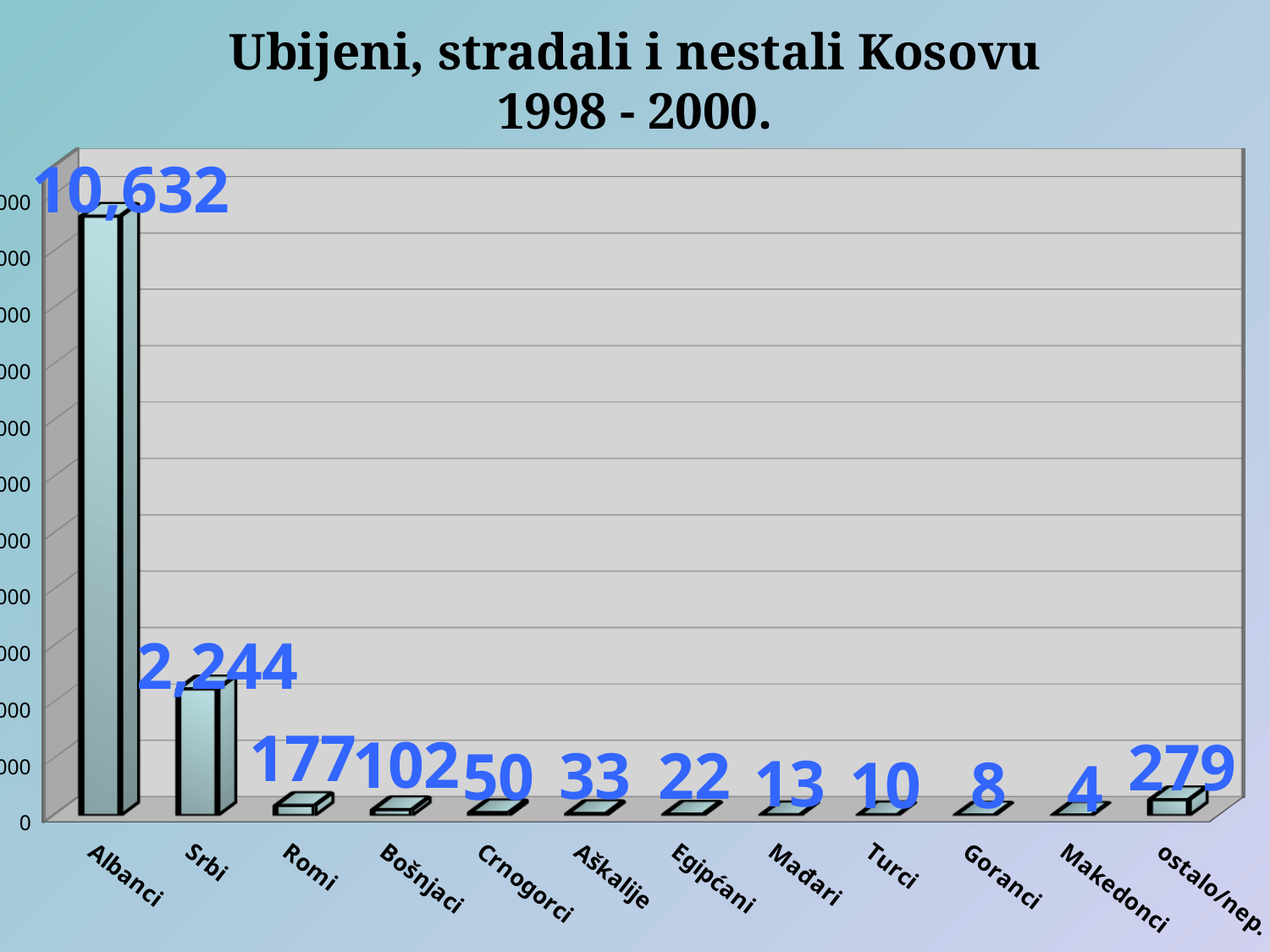
Which is larger, the value for Romi or the value for ostalo/nep.? ostalo/nep. What kind of chart is shown on the slide? bar chart What is the difference between the values for Albanci and Srbi? 8,388 Which category has the highest value? Albanci How many categories are shown on the x axis? 12 What is the value for Romi? 177 What is the value for Srbi? 2,244 What is the value for Albanci? 10,632 What is the title of the chart? Ubijeni, stradali i nestali Kosovu 1998 - 2000. What is the value for ostalo/nep.? 279 Which category has the lowest value? Makedonci What is the difference between the values for Bošnjaci and Crnogorci? 52